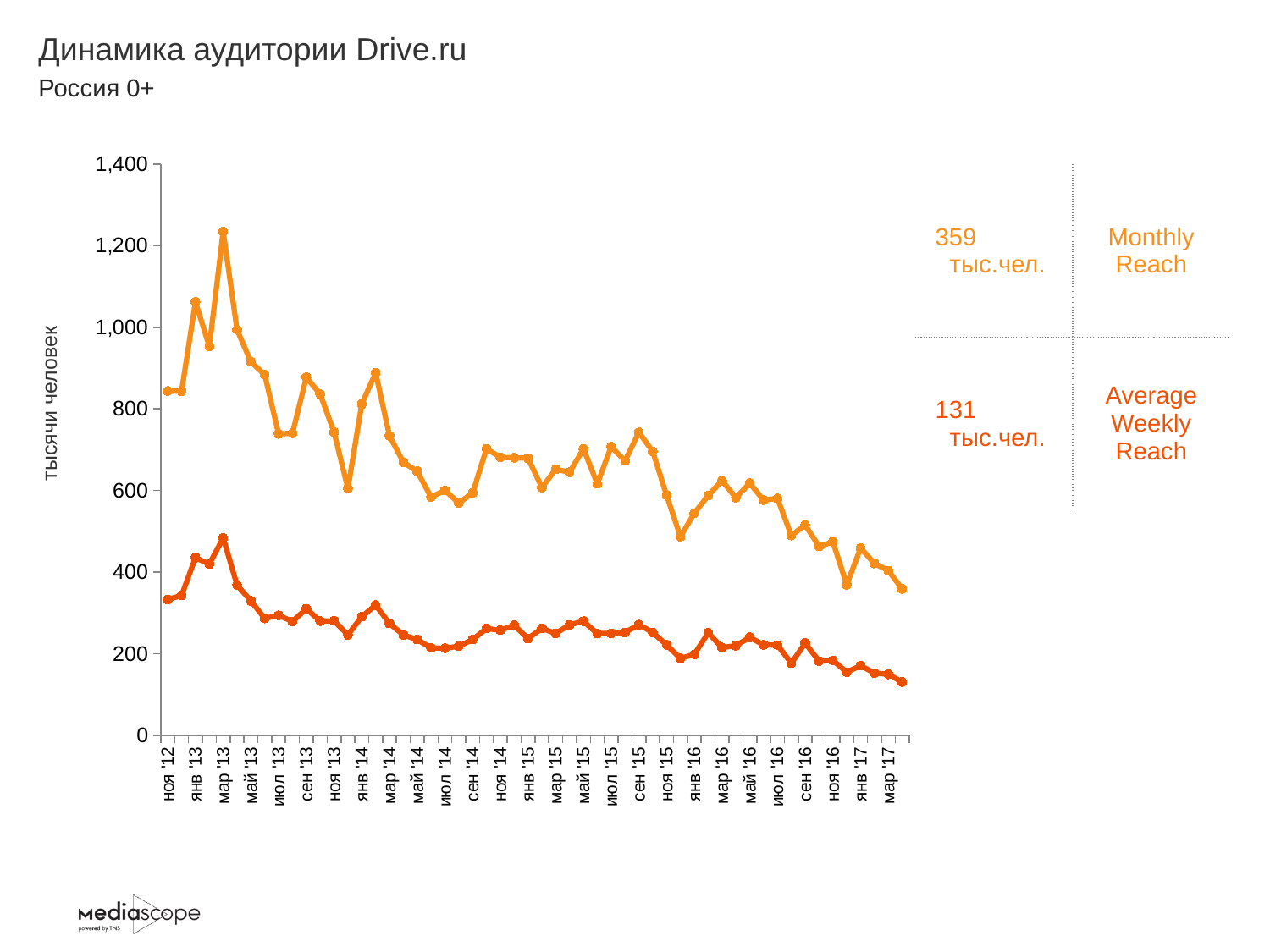
What is the label of the vertical axis? тысячи человек What kind of chart is shown on the slide? line chart What is the latest Average Weekly Reach value shown on the slide? 131 тыс.чел. Is the Average Weekly Reach value at мар '13 greater or less than 400? greater What is the latest Monthly Reach value shown on the slide? 359 тыс.чел. Does the Monthly Reach series generally rise or fall from ноя '12 to мар '17? fall What is the difference between the latest Monthly Reach (359 тыс.чел.) and the latest Average Weekly Reach (131 тыс.чел.)? 228 тыс.чел. Is the Monthly Reach value at мар '13 greater or less than 1,000? greater Is the Monthly Reach value at ноя '12 greater or less than 800? greater How many data series are plotted on the chart? 2 In which month does the Monthly Reach series reach its highest value? мар '13 Which series has the larger value at сен '15, Monthly Reach or Average Weekly Reach? Monthly Reach